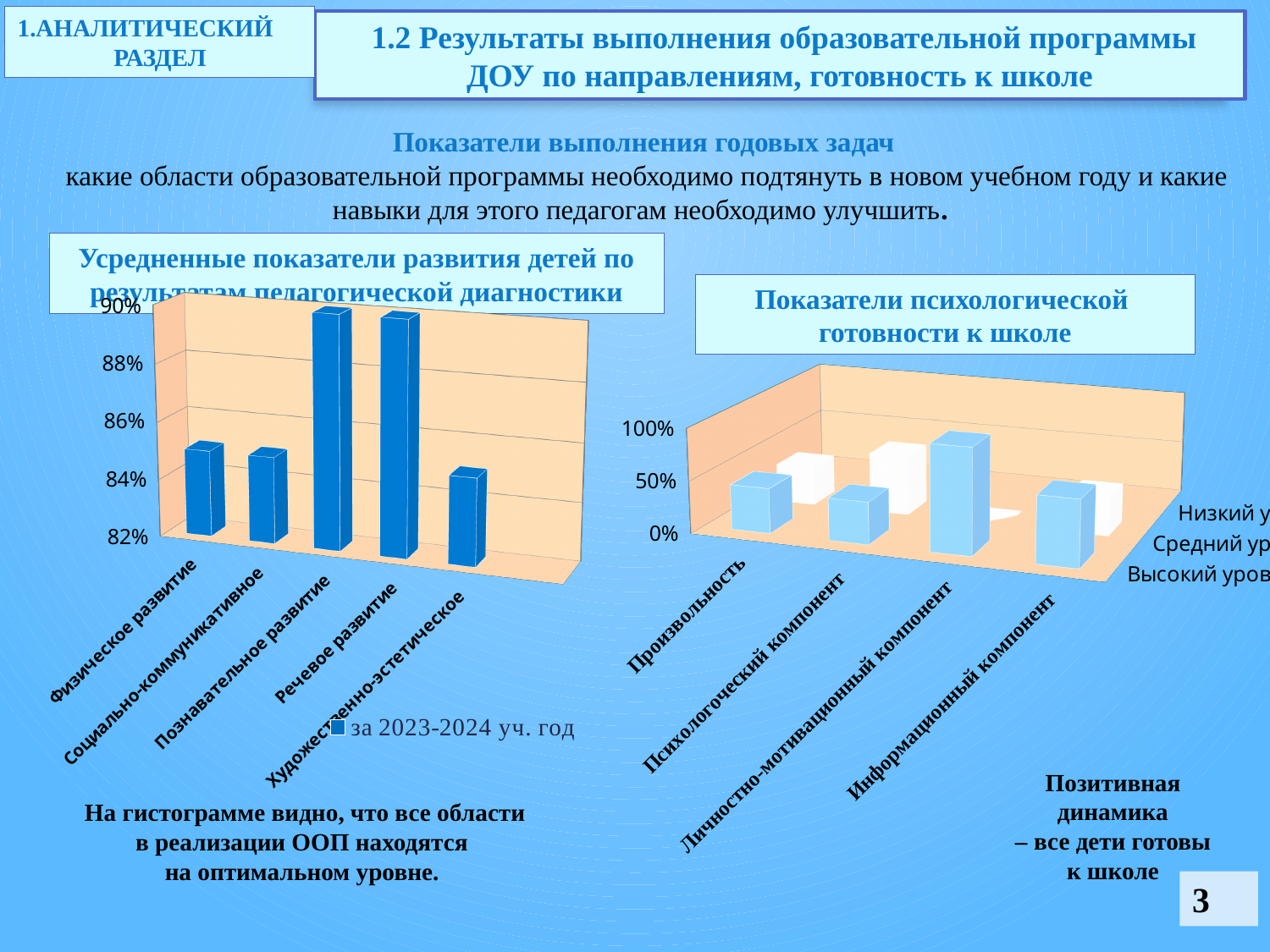
How many categories are shown on the x axis of the left chart ("Усредненные показатели развития детей")? 5 In the left chart ("Усредненные показатели развития детей"), which is larger: the value for Речевое развитие or the value for Социально-коммуникативное? Речевое развитие What is the highest tick value shown on the vertical axis of the right chart ("Показатели психологической готовности к школе")? 100% What is the legend entry of the left chart ("Усредненные показатели развития детей")? за 2023-2024 уч. год In the left chart ("Усредненные показатели развития детей"), is the value for Физическое развитие greater or less than 84%? greater How many categories are shown on the x axis of the right chart ("Показатели психологической готовности к школе")? 4 In the left chart ("Усредненные показатели развития детей"), is the value for Художественно-эстетическое greater or less than 86%? less In the right chart ("Показатели психологической готовности к школе"), is the Высокий уровень value for Личностно-мотивационный компонент greater or less than 50%? greater What kind of chart is the right chart titled "Показатели психологической готовности к школе"? bar chart What kind of chart is the left chart titled "Усредненные показатели развития детей по результатам педагогической диагностики"? bar chart How many series does the legend of the left chart ("Усредненные показатели развития детей") list? 1